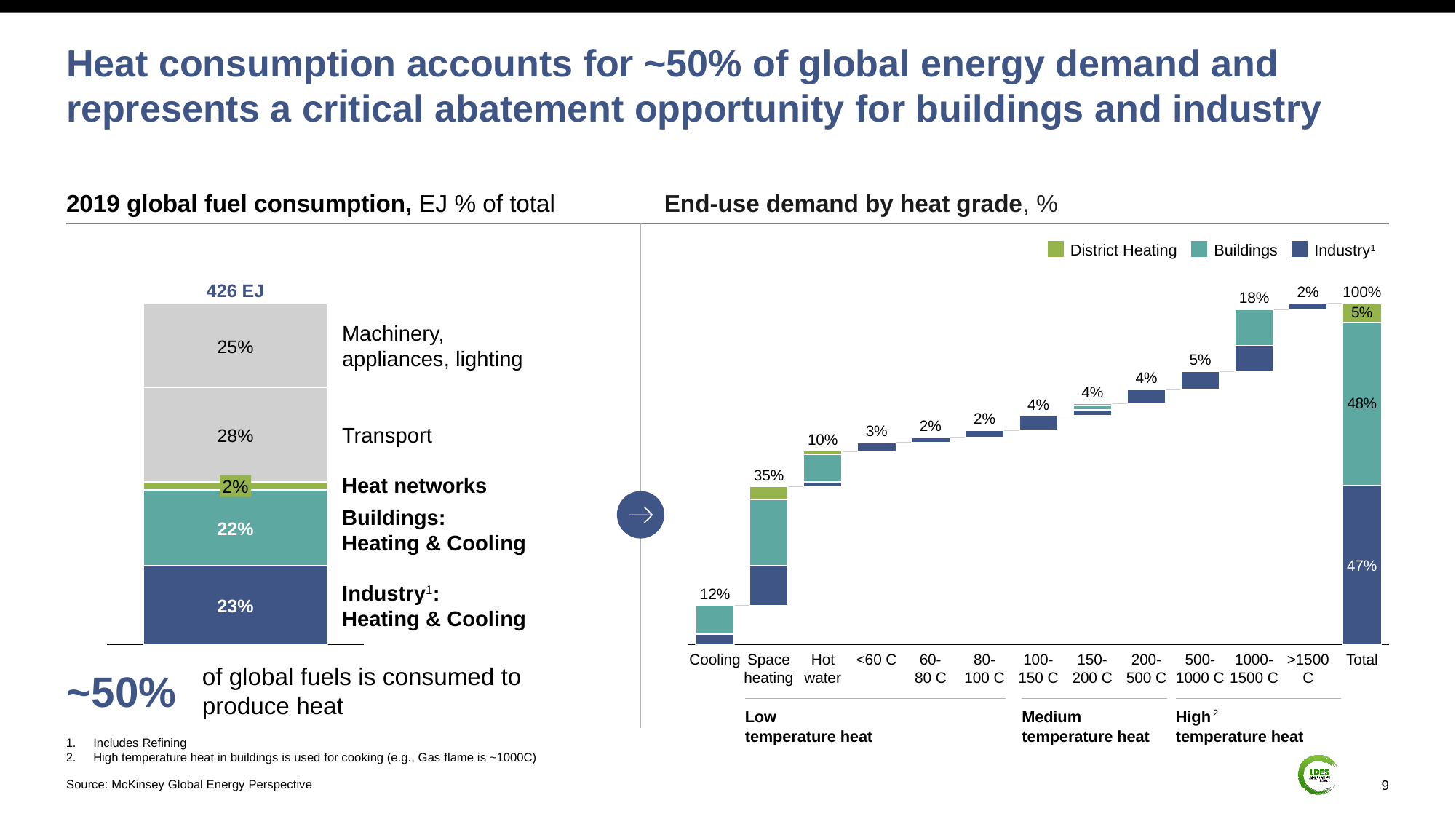
In the '2019 global fuel consumption' chart, what is the difference between the Transport share and the Buildings: Heating & Cooling share? 6% In the 'End-use demand by heat grade' chart, what is the value for Space heating? 35% In the '2019 global fuel consumption' chart, what share is attributed to Transport? 28% In the 'End-use demand by heat grade' chart, how many series does the legend list? 3 In the 'End-use demand by heat grade' chart, which is larger: the value for Cooling or the value for Hot water? Cooling In the '2019 global fuel consumption' chart, which segment has the smallest share? Heat networks In the 'End-use demand by heat grade' chart, which category has the highest value (excluding Total)? Space heating In the 'End-use demand by heat grade' chart, what share of the Total bar is Buildings? 48% In the 'End-use demand by heat grade' chart, what is the value for 1000-1500 C? 18% In the '2019 global fuel consumption' chart, what share is attributed to Industry: Heating & Cooling? 23% In the 'End-use demand by heat grade' chart, how many categories are shown on the x axis, including Total? 13 In the '2019 global fuel consumption' chart, what total value in EJ is shown above the bar? 426 EJ